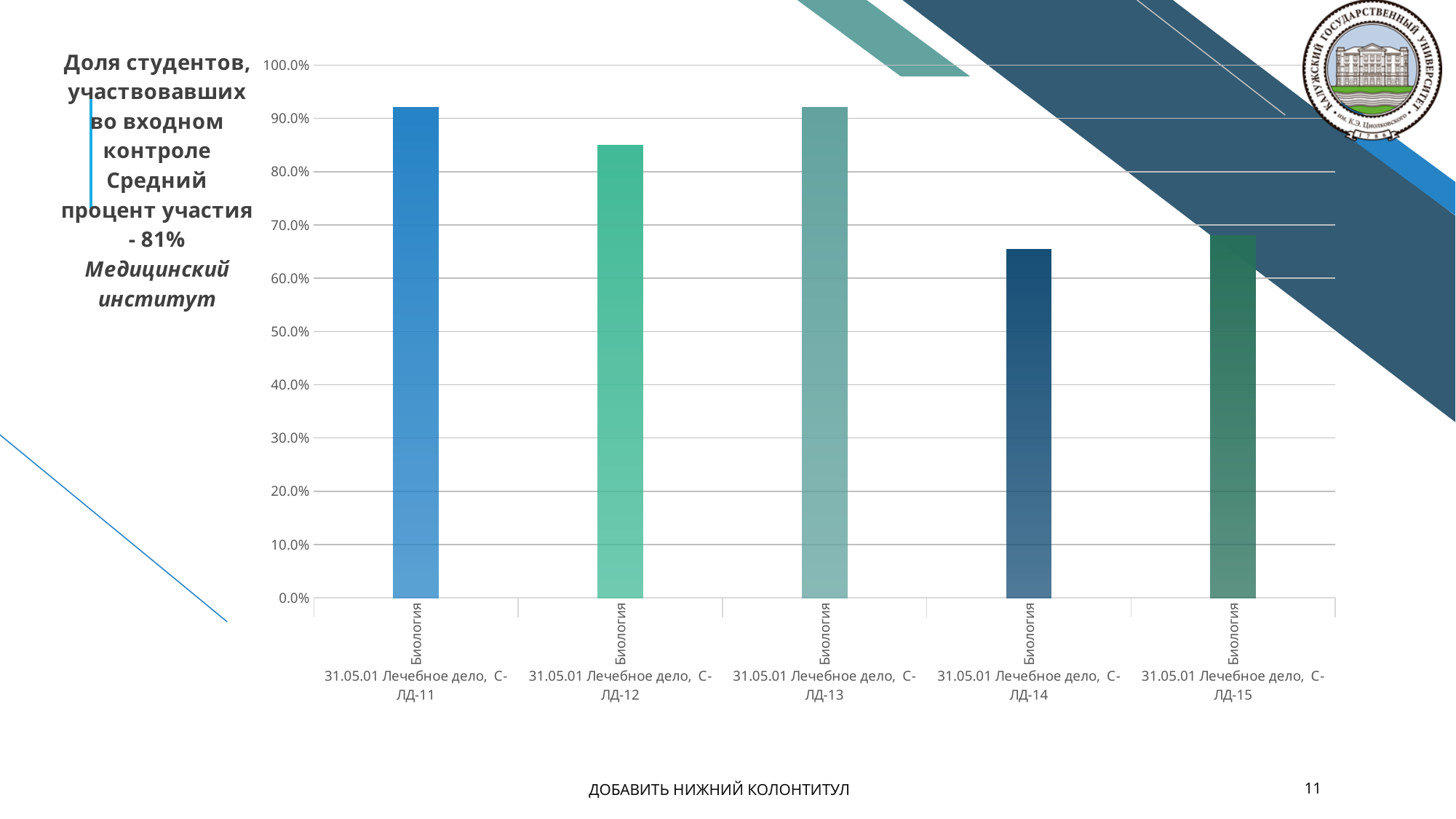
How many bars (groups) are plotted in the chart? 5 Is the value for С-ЛД-14 greater or less than 70.0%? less Which group has the lowest share of students who took part in the entrance control? 31.05.01 Лечебное дело, С-ЛД-14 Is the value for С-ЛД-11 greater or less than 80.0%? greater What kind of chart is shown on the slide? bar chart Which is larger, the value for С-ЛД-11 or the value for С-ЛД-14? С-ЛД-11 Is the value for С-ЛД-13 greater or less than 80.0%? greater According to the text next to the chart, what is the average participation percentage? 81% Which is larger, the value for С-ЛД-12 or the value for С-ЛД-15? С-ЛД-12